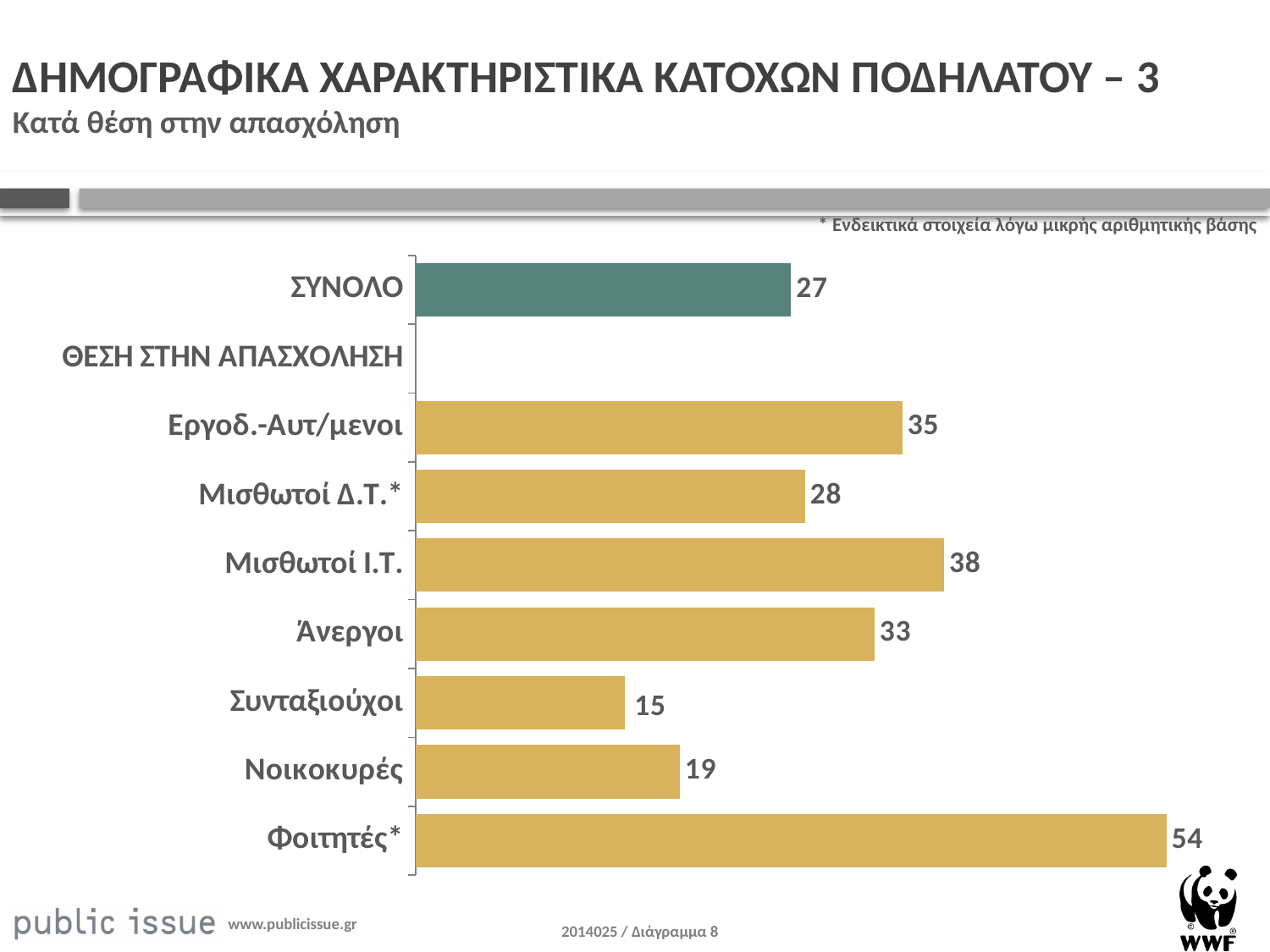
Which category has the highest value? Φοιτητές* Which category has the lowest value? Συνταξιούχοι Which bar is shown in a different colour from the others? ΣΥΝΟΛΟ What is the difference between the values for Φοιτητές* and Νοικοκυρές? 35 What is the value for Μισθωτοί Ι.Τ.? 38 What is the value for ΣΥΝΟΛΟ? 27 What is the value for Φοιτητές*? 54 How many bars are plotted on the chart? 8 What is the difference between the values for Εργοδ.-Αυτ/μενοι and Μισθωτοί Δ.Τ.*? 7 What is the value for Συνταξιούχοι? 15 Which is larger, the value for Άνεργοι or the value for Μισθωτοί Δ.Τ.*? Άνεργοι What kind of chart is shown on the slide? Bar chart